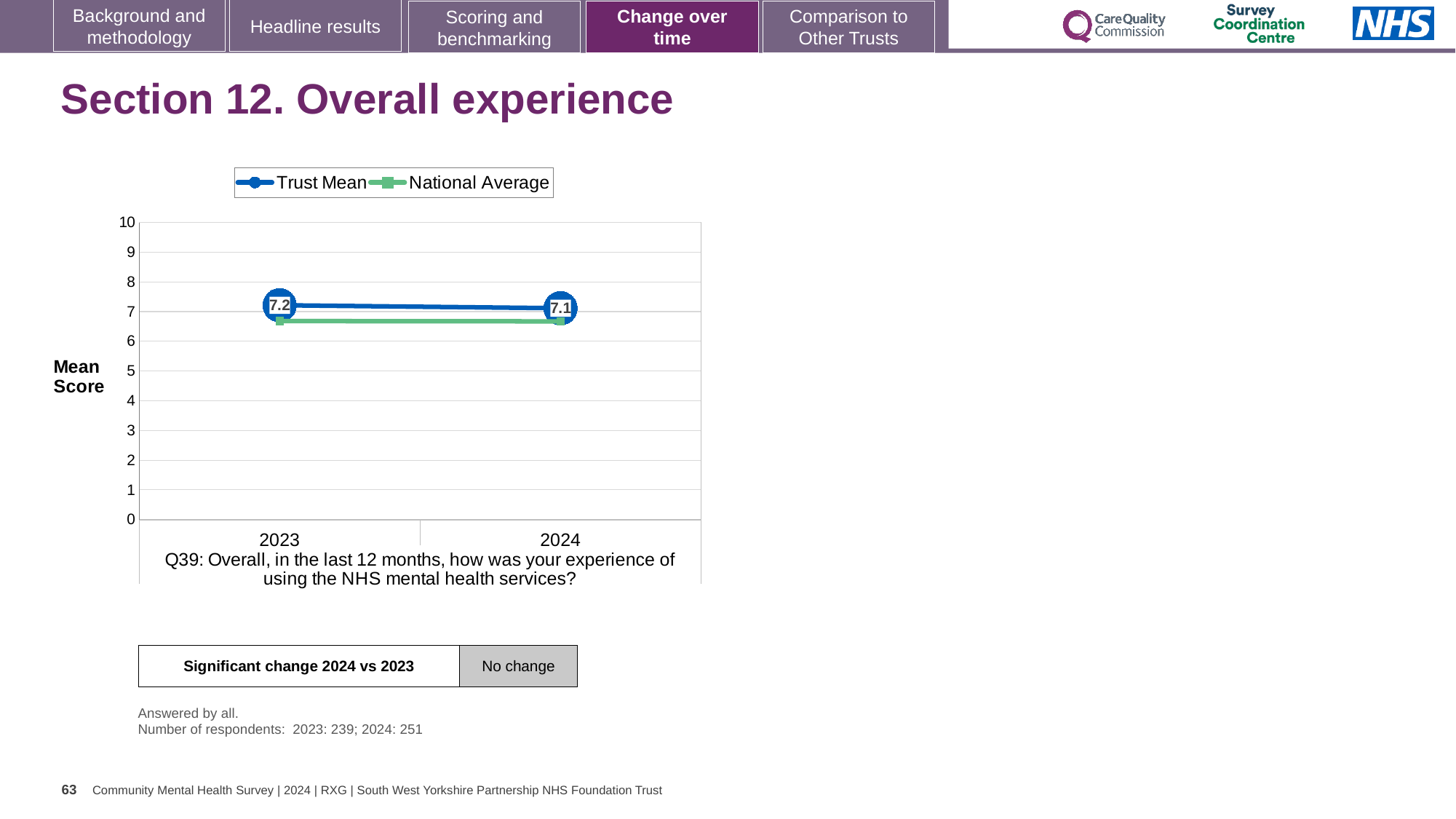
Which year has the higher Trust Mean, 2023 or 2024? 2023 How many years are plotted on the x axis? 2 What is the Trust Mean value for 2023? 7.2 Is the National Average value for 2024 greater or less than 6? greater Does the Trust Mean rise or fall from 2023 to 2024? fall What kind of chart is shown on the slide? line chart Is the National Average value for 2023 greater or less than 7? less What is the Trust Mean value for 2024? 7.1 What is the difference between the Trust Mean in 2023 and in 2024? 0.1 In 2024, which is higher, the Trust Mean or the National Average? Trust Mean How many series does the legend list? 2 What is the label on the y axis of the chart? Mean Score